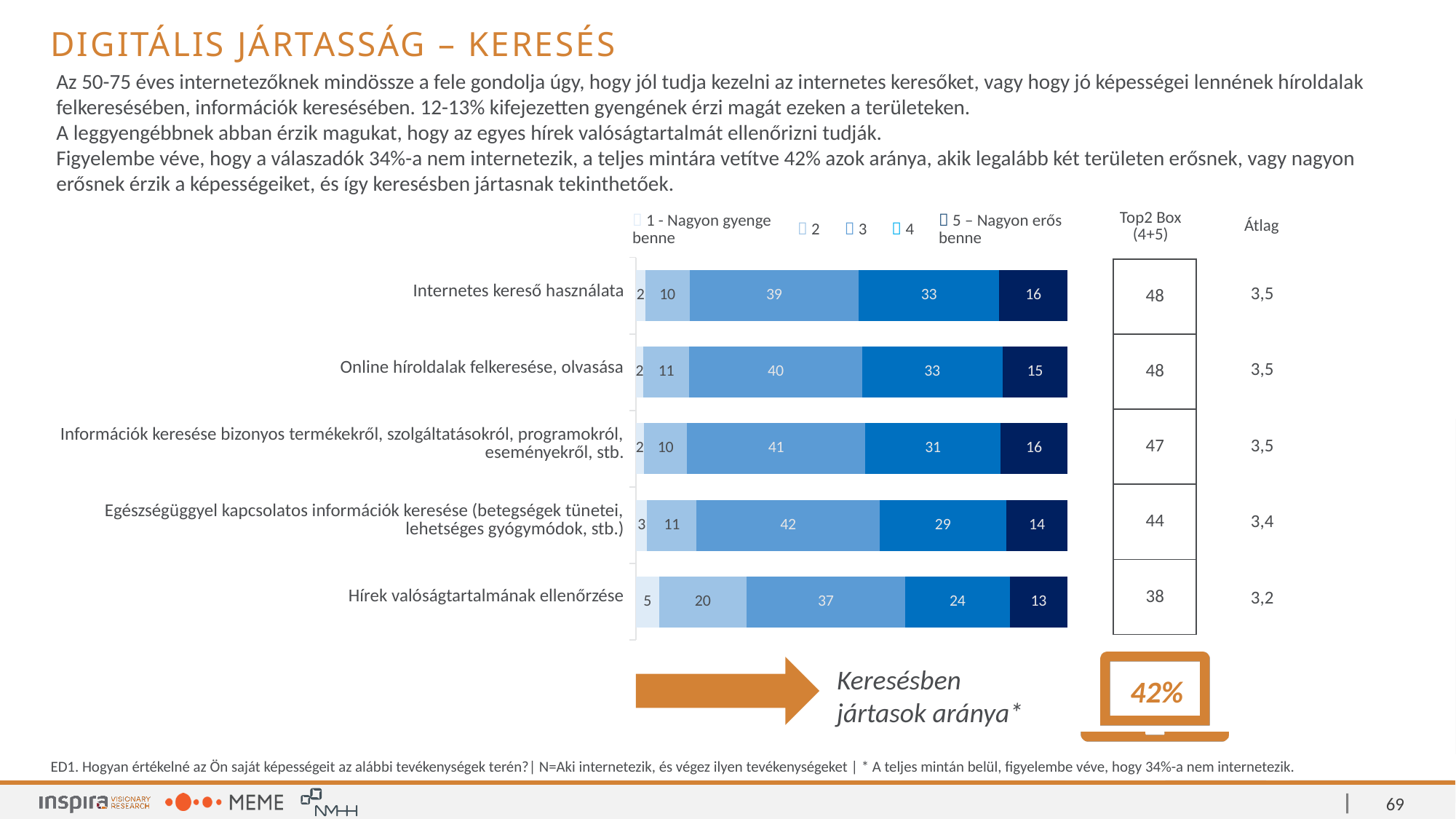
What kind of chart is shown on the slide? stacked bar chart What is the value of the "3" segment for "Információk keresése bizonyos termékekről, szolgáltatásokról, programokról, eseményekről, stb."? 41 How many categories (activities) are plotted in the chart? 5 How many series does the chart legend list? 5 What is the value of the "2" segment for "Hírek valóságtartalmának ellenőrzése"? 20 What is the total of the stacked bar for "Hírek valóságtartalmának ellenőrzése"? 99 Which category has the highest value for the "1 - Nagyon gyenge benne" segment? Hírek valóságtartalmának ellenőrzése What is the difference between the "3" segment values for "Egészségüggyel kapcsolatos információk keresése" and "Hírek valóságtartalmának ellenőrzése"? 5 Which has a larger "4" segment value: "Internetes kereső használata" or "Egészségüggyel kapcsolatos információk keresése"? Internetes kereső használata What is the label of the first legend entry in the chart? 1 - Nagyon gyenge benne Which category has the lowest value for the "4" segment? Hírek valóságtartalmának ellenőrzése What is the value of the "5 – Nagyon erős benne" segment for "Internetes kereső használata"? 16